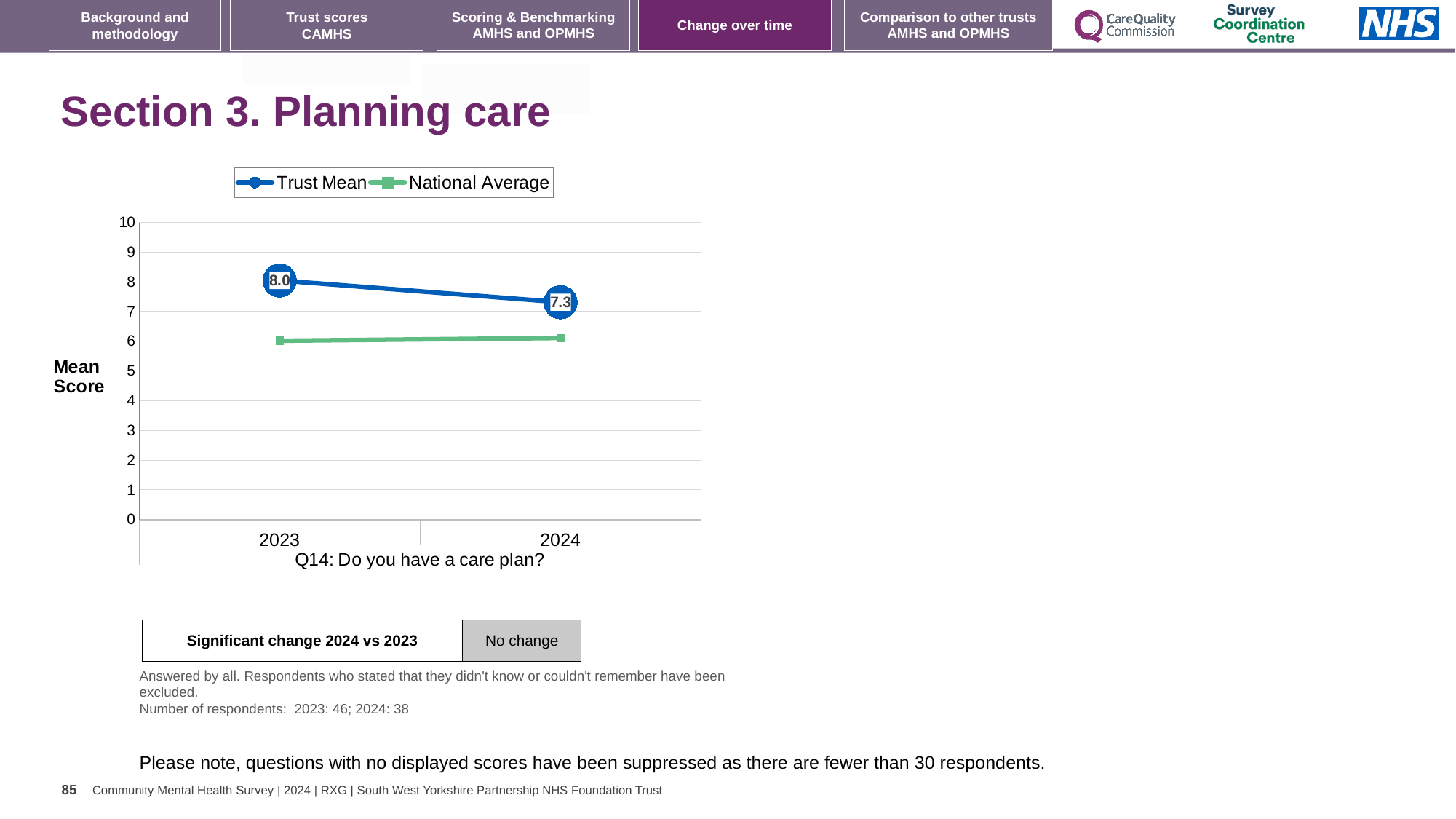
Is the National Average for 2023 greater or less than 7? less What is the difference between the Trust Mean scores for 2023 and 2024? 0.7 Which year has the lower Trust Mean score? 2024 How many years are shown on the x axis? 2 Which year has the higher Trust Mean score? 2023 What is the Trust Mean score for 2023? 8.0 What is the Trust Mean score for 2024? 7.3 Is the Trust Mean for 2024 greater or less than the National Average for 2024? greater How many series does the legend list? 2 Does the Trust Mean rise or fall from 2023 to 2024? fall Is the National Average for 2024 greater or less than 5? greater What kind of chart is shown? line chart